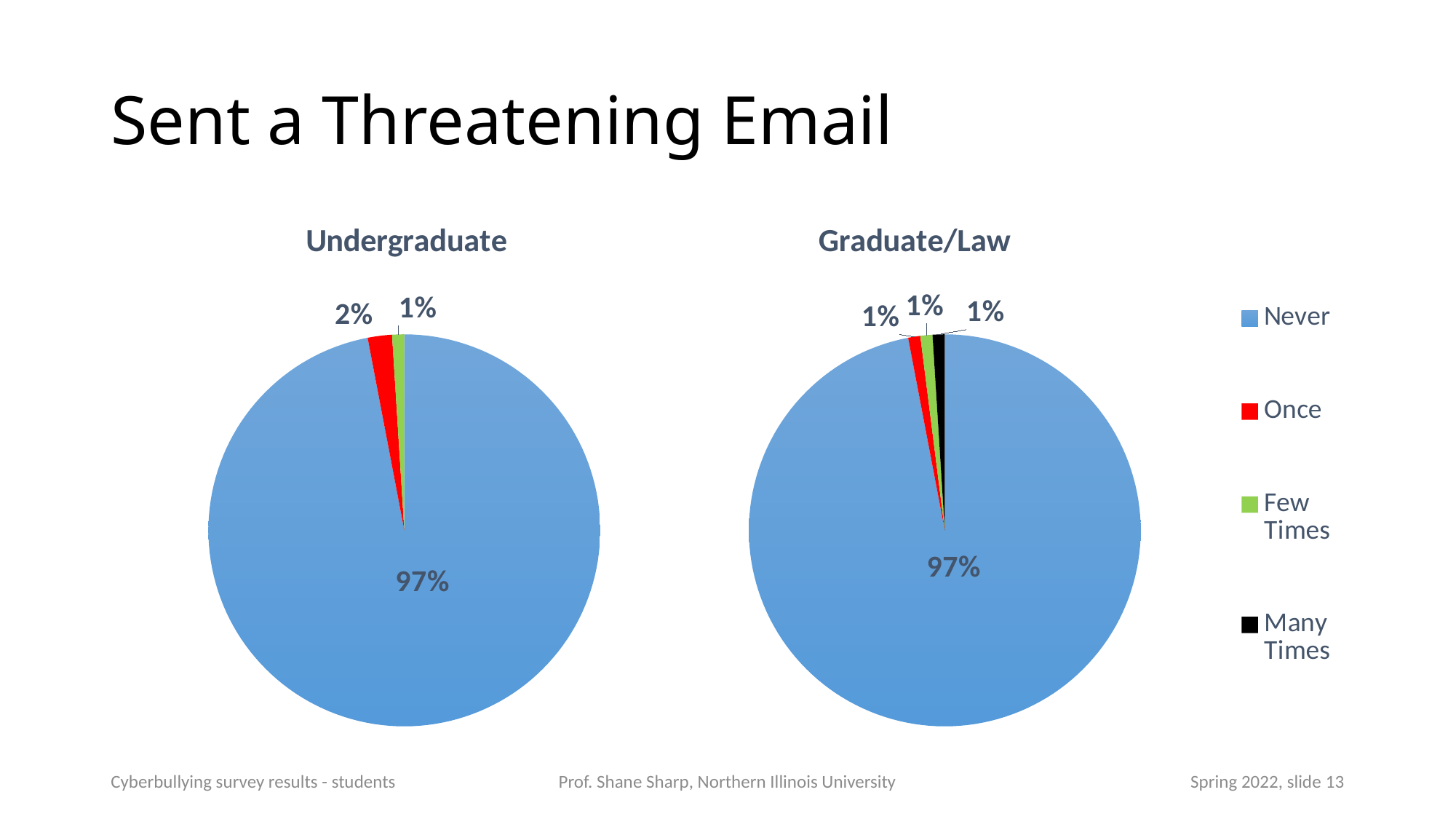
How many slices are shown in the Graduate/Law pie chart? 4 In the Undergraduate pie chart, what share of respondents answered Never? 97% What type of chart is used for the Undergraduate data? Pie chart In the Graduate/Law pie chart, what share of respondents answered Never? 97% In the Graduate/Law pie chart, what percentage is shown for Many Times? 1% In the Undergraduate pie chart, what percentage is shown for Once? 2% In the Undergraduate pie chart, what percentage is shown for Few Times? 1% In the Undergraduate pie chart, what is the difference between the Never share and the Once share? 95% In the Undergraduate pie chart, which category has the largest slice? Never In the Undergraduate pie chart, which is larger, the Once slice or the Few Times slice? Once How many entries does the legend list? 4 Which colour represents Many Times in the legend? Black